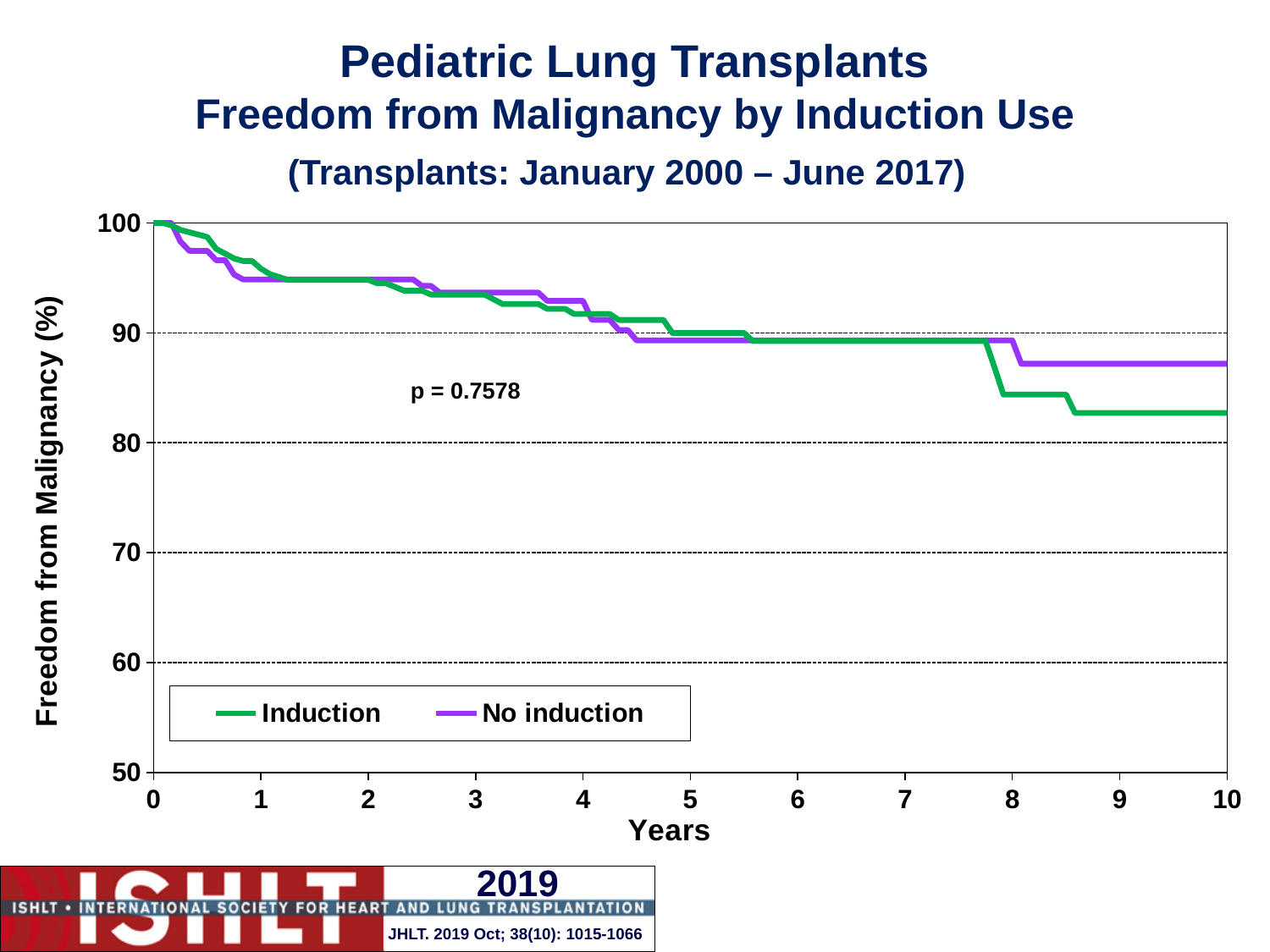
Is the value for the No induction series at 5 years greater or less than 80? greater Do the values for the Induction series rise or fall as years increase? Fall What is the label of the x axis? Years Is the value for the Induction series at 9 years greater or less than 80? greater What p-value is printed on the chart? p = 0.7578 How many series does the legend list? 2 Do the values for the No induction series rise or fall as years increase? Fall Which two series are listed in the legend? Induction and No induction At 10 years, which series has the higher freedom from malignancy, Induction or No induction? No induction Is the value for the Induction series at 10 years greater or less than 90? less What kind of chart is shown on the slide? Line chart